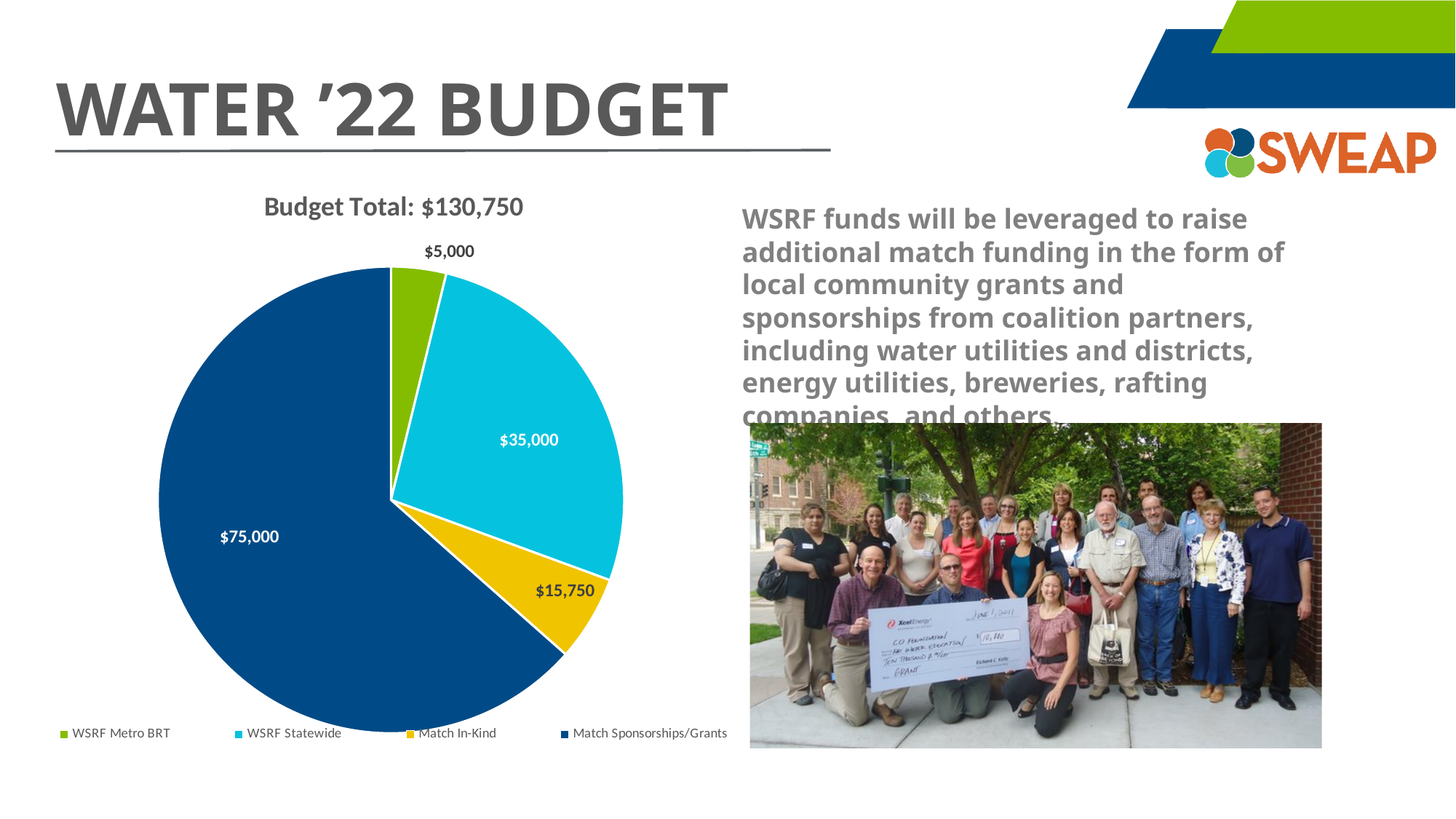
How many categories does the pie chart show? 4 What type of chart is shown on the slide? Pie chart Which category has the largest slice in the pie chart? Match Sponsorships/Grants What is the value of the Match In-Kind slice in the pie chart? $15,750 What is the value of the WSRF Metro BRT slice in the pie chart? $5,000 Which is larger, Match In-Kind or WSRF Metro BRT? Match In-Kind What is the value of the Match Sponsorships/Grants slice in the pie chart? $75,000 What is the difference between the WSRF Statewide value and the Match In-Kind value? $19,250 What is the title of the chart? Budget Total: $130,750 What is the difference between the Match Sponsorships/Grants value and the WSRF Statewide value? $40,000 Which category has the smallest slice in the pie chart? WSRF Metro BRT What is the value of the WSRF Statewide slice in the pie chart? $35,000